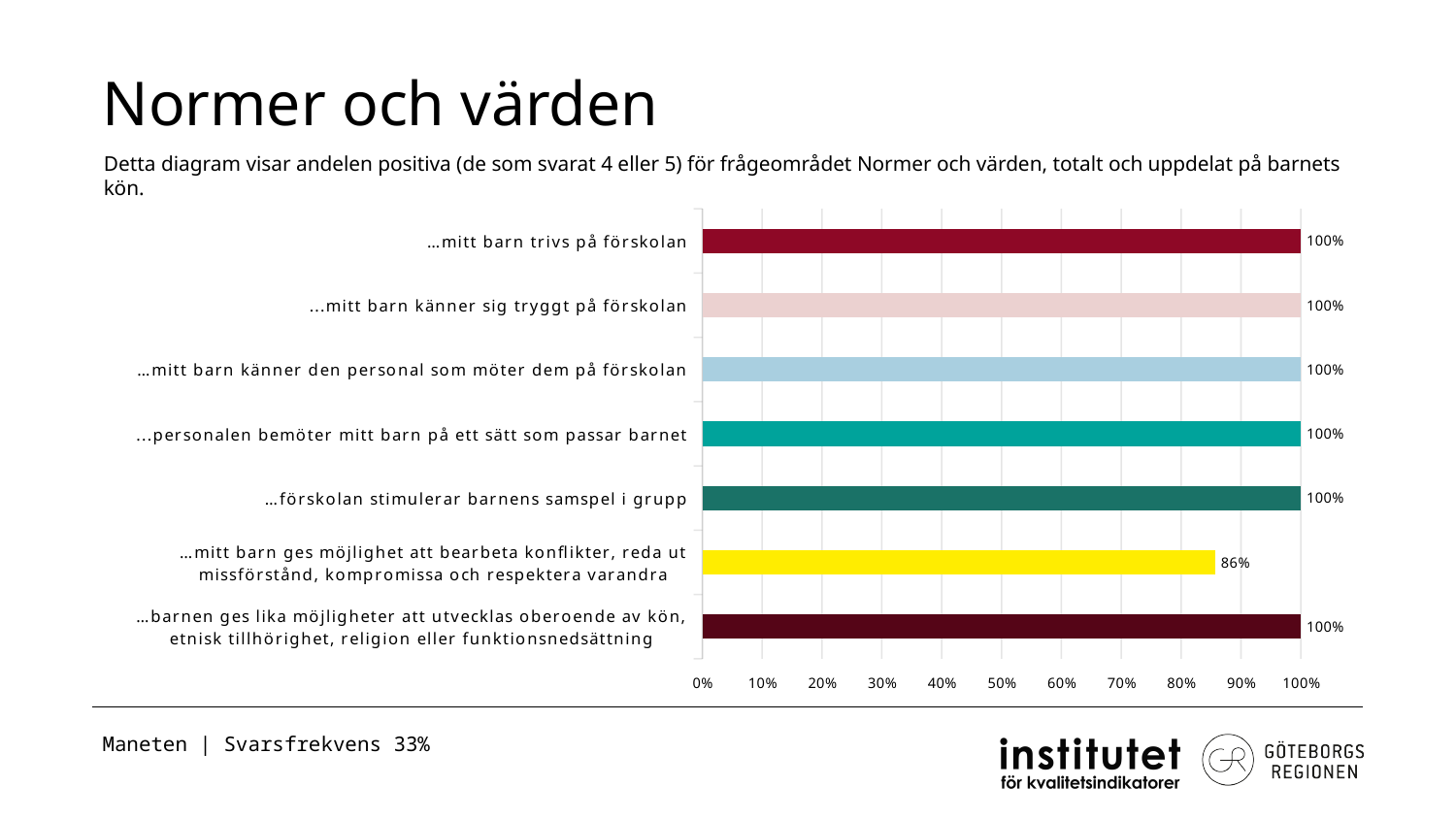
Which category has the lowest value? …mitt barn ges möjlighet att bearbeta konflikter, reda ut missförstånd, kompromissa och respektera varandra Is the value for "…mitt barn ges möjlighet att bearbeta konflikter, reda ut missförstånd, kompromissa och respektera varandra" greater or less than 90%? less What is the value for "…mitt barn ges möjlighet att bearbeta konflikter, reda ut missförstånd, kompromissa och respektera varandra"? 86% How many categories (bars) does the chart show? 7 How many categories have a value of 100%? 6 What is the value for "…barnen ges lika möjligheter att utvecklas oberoende av kön, etnisk tillhörighet, religion eller funktionsnedsättning"? 100% What is the value for "…förskolan stimulerar barnens samspel i grupp"? 100% What is the value for "…mitt barn trivs på förskolan"? 100% What is the difference between the value for "…förskolan stimulerar barnens samspel i grupp" and the value for "…mitt barn ges möjlighet att bearbeta konflikter, reda ut missförstånd, kompromissa och respektera varandra"? 14% What kind of chart is shown on the slide? bar chart Which is larger: the value for "…personalen bemöter mitt barn på ett sätt som passar barnet" or the value for "…mitt barn ges möjlighet att bearbeta konflikter, reda ut missförstånd, kompromissa och respektera varandra"? …personalen bemöter mitt barn på ett sätt som passar barnet What is the title of the slide containing the chart? Normer och värden